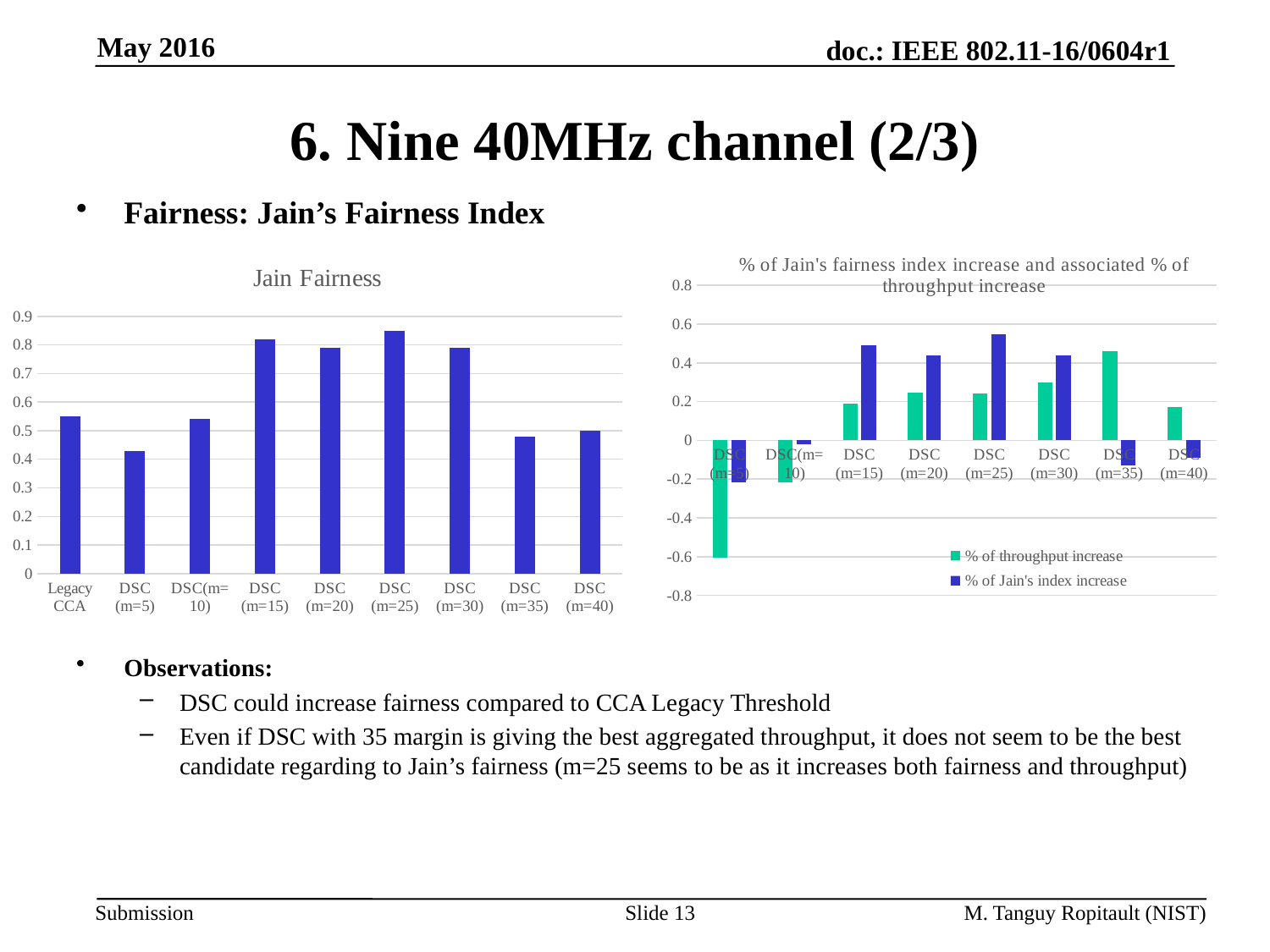
In the 'Jain Fairness' chart, which category has the lowest value? DSC (m=5) How many categories are shown on the x axis of the 'Jain Fairness' chart? 9 What kind of chart is the 'Jain Fairness' chart on the left? bar chart In the 'Jain Fairness' chart, is the value for DSC (m=5) greater or less than 0.5? less How many series does the legend of the right-hand chart ('% of Jain's fairness index increase and associated % of throughput increase') list? 2 In the right-hand chart, is the '% of throughput increase' for DSC (m=5) greater or less than -0.4? less In the right-hand chart, which category has the highest '% of Jain's index increase'? DSC (m=25) In the 'Jain Fairness' chart, which is larger, the value for Legacy CCA or the value for DSC (m=15)? DSC (m=15) In the 'Jain Fairness' chart, is the value for DSC (m=25) greater or less than 0.8? greater In the right-hand chart, for DSC (m=35), which is larger, the '% of throughput increase' or the '% of Jain's index increase'? % of throughput increase In the right-hand chart, which category has the highest '% of throughput increase'? DSC (m=35)